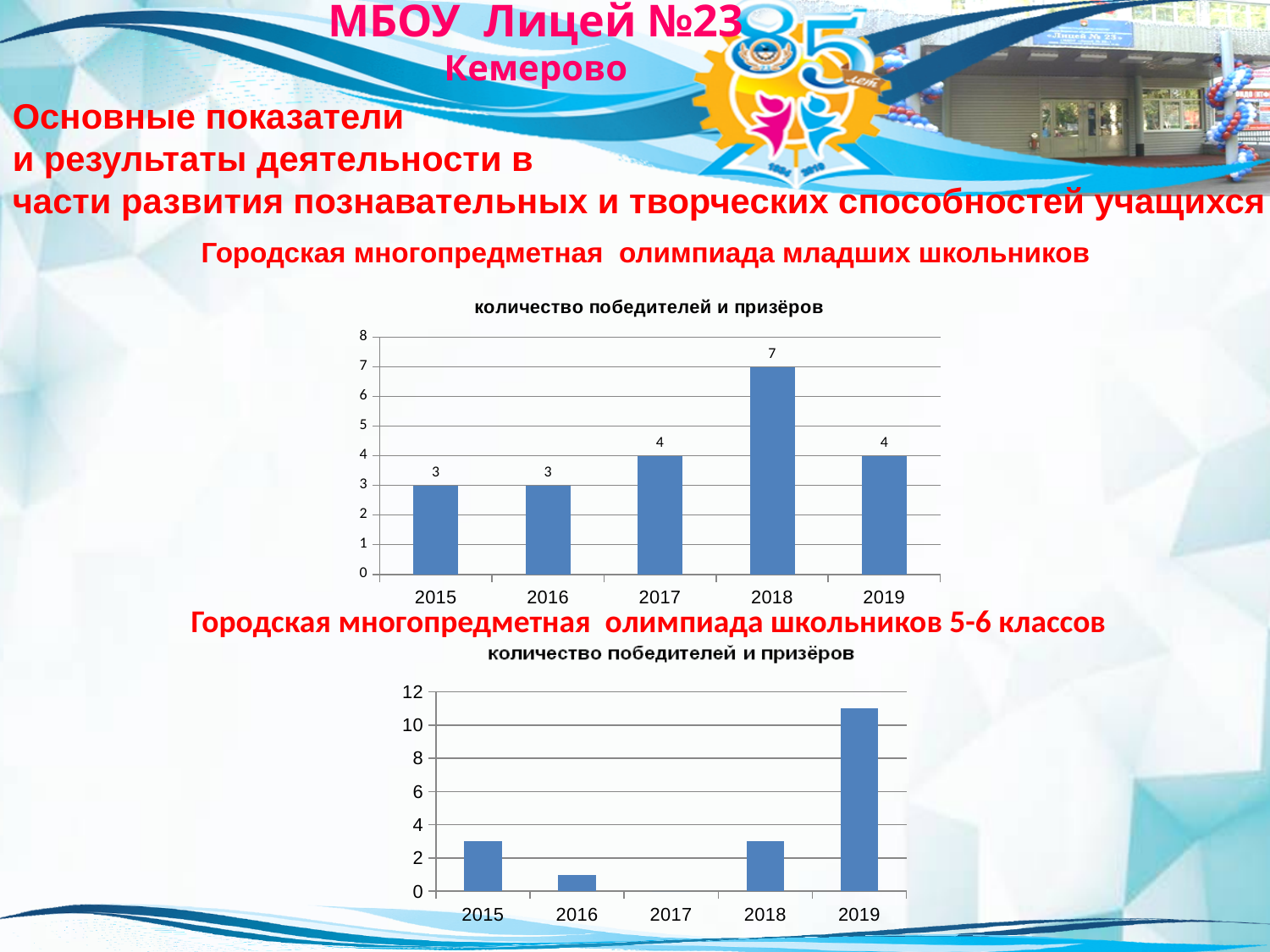
In the top chart, what is the difference between the values for 2018 and 2017? 3 What is the title of the bottom chart? количество победителей и призёров In the bottom chart, is the value for 2016 greater or less than 2? less How many years are shown on the x axis of the top chart? 5 What kind of chart is the top chart? bar chart In the top chart, which year has the highest value? 2018 In the top chart, what is the value for 2018? 7 In the bottom chart, is the value for 2019 greater or less than 10? greater In the top chart, what is the value for 2015? 3 In the top chart, which is larger, the value for 2017 or the value for 2016? 2017 In the bottom chart, which is larger, the value for 2018 or the value for 2016? 2018 In the bottom chart, which year has the highest value? 2019